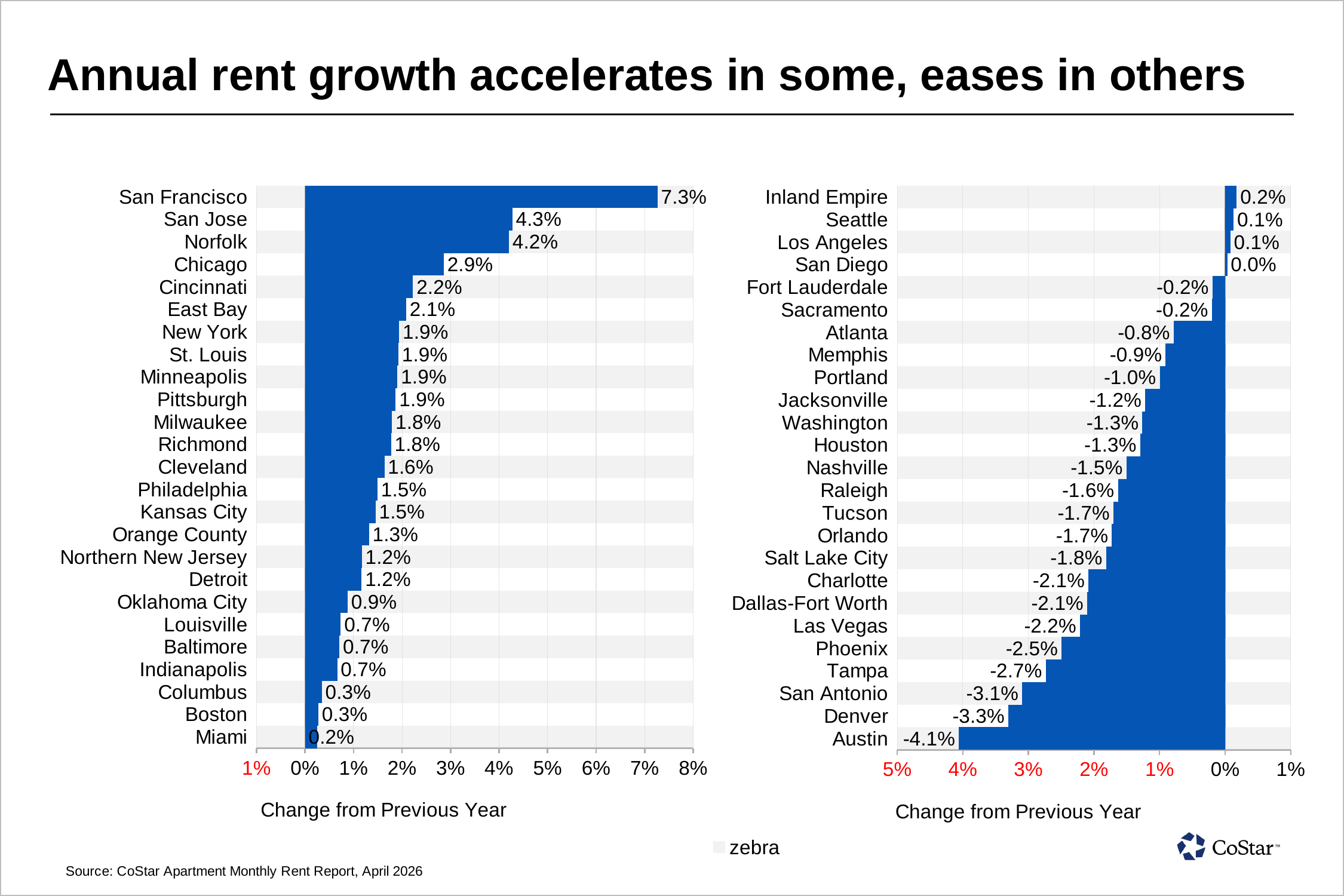
On the right chart, which market has the lowest change from previous year? Austin On the right chart, what is the change from previous year for Austin? -4.1% On the right chart, how many markets are listed? 25 On the left chart, what is the change from previous year for San Francisco? 7.3% On the right chart, what is the value for Phoenix? -2.5% On the left chart, how many markets are listed? 25 On the left chart, what is the value for Chicago? 2.9% On the left chart, which market has the highest annual rent growth? San Francisco On the left chart, what is the difference between San Francisco's and San Jose's values? 3.0% What is the x-axis label on the right chart? Change from Previous Year What type of chart is used on the left side of the slide? Bar chart